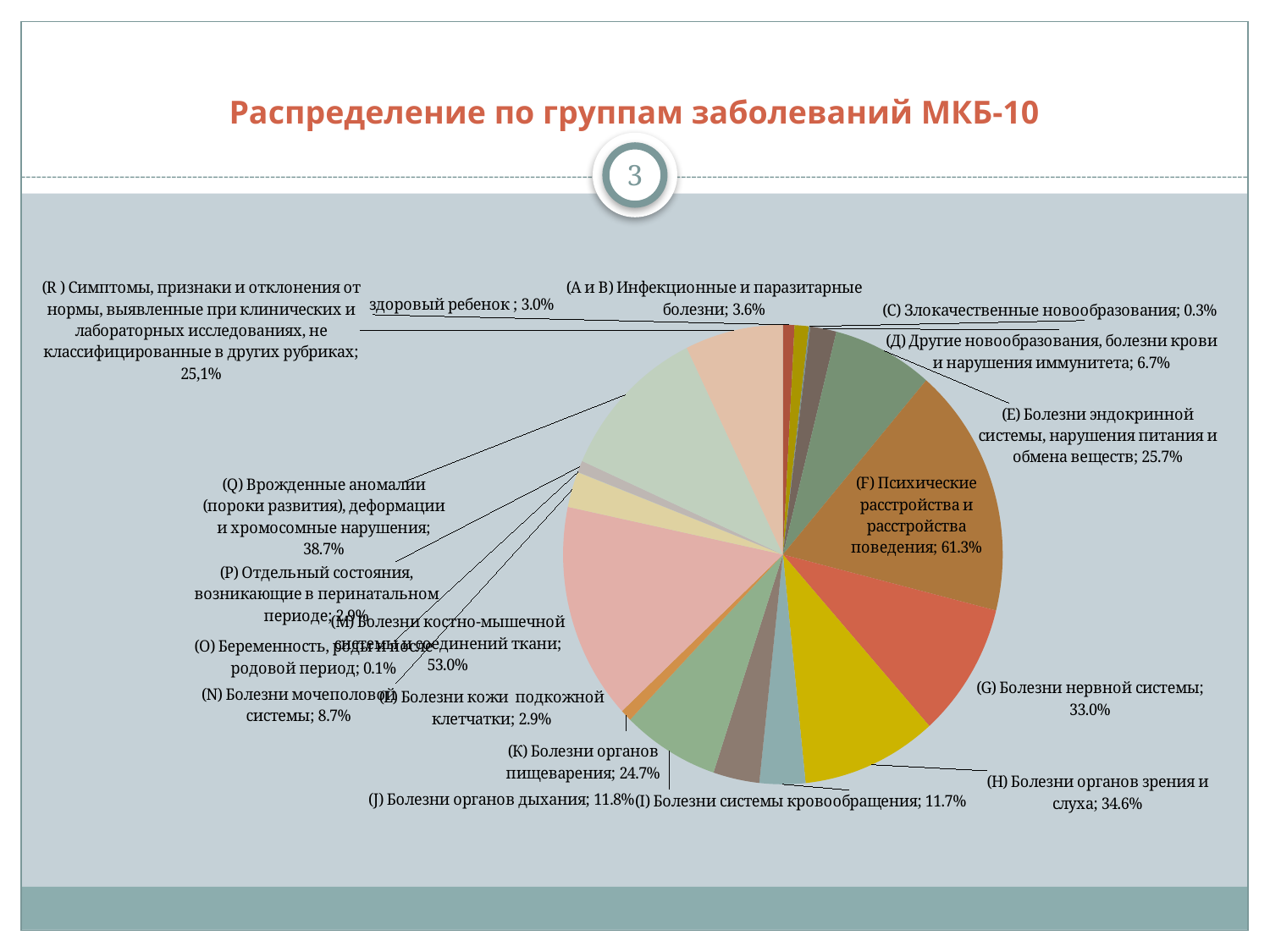
What percentage is shown for (C) Злокачественные новообразования? 0.3% What percentage is shown for (E) Болезни эндокринной системы, нарушения питания и обмена веществ? 25.7% What percentage is shown for (N) Болезни мочеполовой системы? 8.7% What percentage is shown for (F) Психические расстройства и расстройства поведения? 61.3% What percentage is shown for (H) Болезни органов зрения и слуха? 34.6% Which category has the smallest labelled percentage in the pie chart? (O) Беременность, роды и послеродовой период Which category has the largest labelled percentage in the pie chart? (F) Психические расстройства и расстройства поведения Which is larger: the value for (F) Психические расстройства и расстройства поведения or for (M) Болезни костно-мышечной системы и соединений ткани? (F) Психические расстройства и расстройства поведения What is the title of the chart on the slide? Распределение по группам заболеваний МКБ-10 How many slices does the pie chart have? 18 What type of chart is shown on the slide? pie chart What is the difference between the labelled values for (H) Болезни органов зрения и слуха and (G) Болезни нервной системы? 1.6%